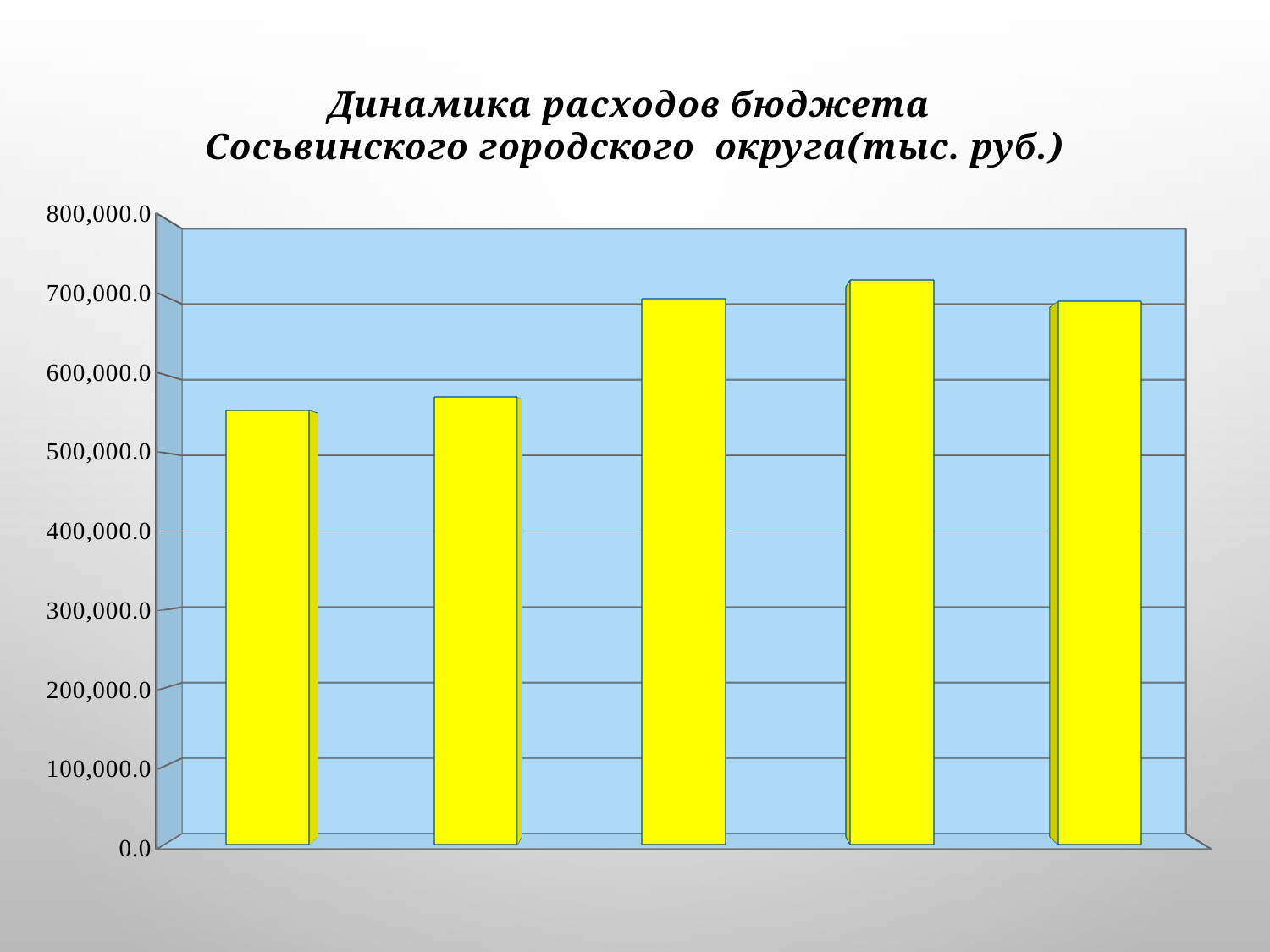
How many bars are plotted in the chart? 5 Is the value of the second bar from the left greater or less than 600,000.0? less Is the value of the rightmost bar greater or less than 600,000.0? greater What kind of chart is shown on the slide? bar chart What is the title of the chart? Динамика расходов бюджета Сосьвинского городского округа(тыс. руб.) Is the value of the leftmost bar greater or less than 500,000.0? greater Which bar is the tallest in the chart? the fourth bar from the left Which bar is the shortest in the chart? the leftmost bar What colour are the bars in the chart? yellow